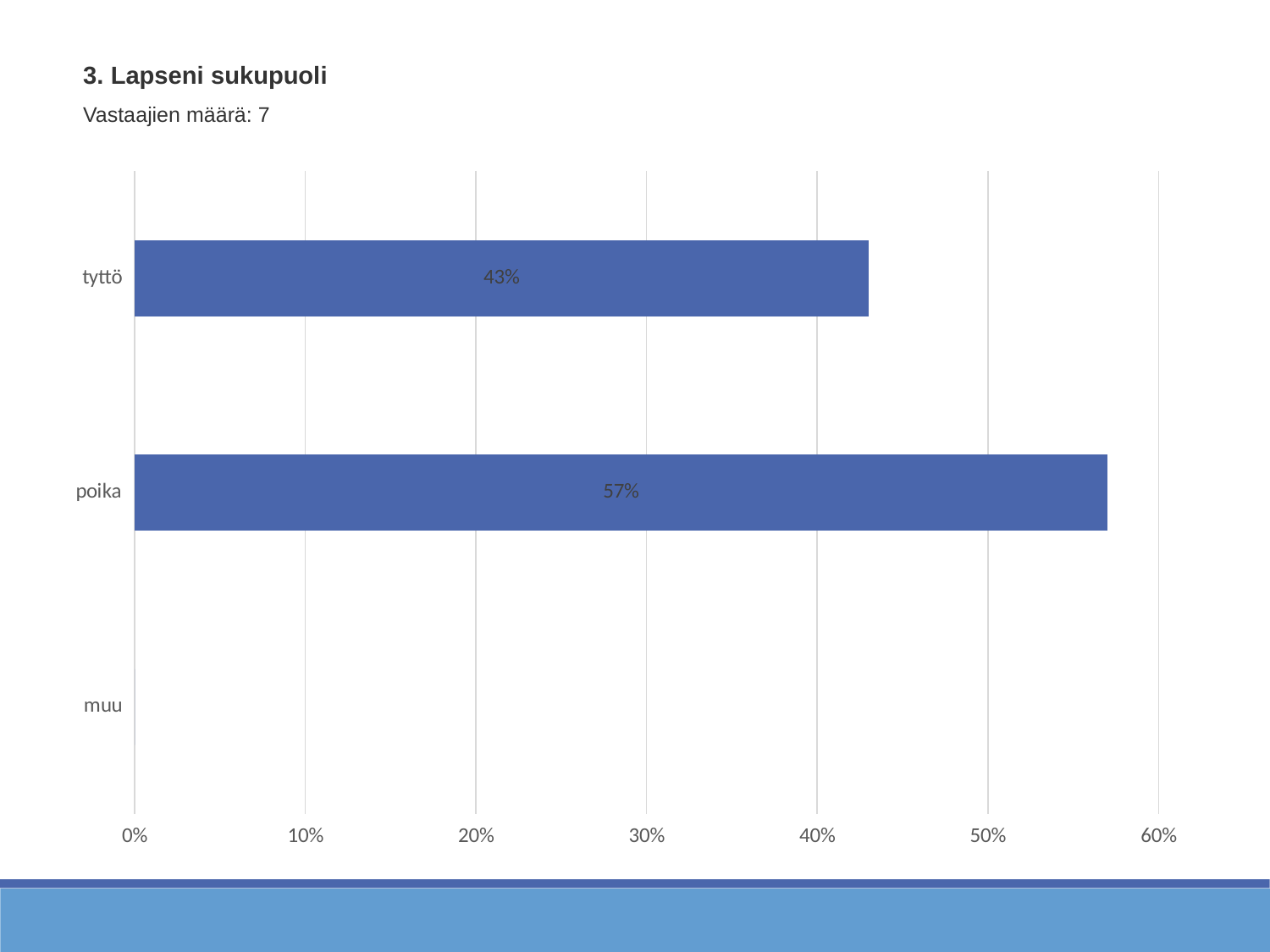
Is the value for poika greater or less than 50%? greater What is the value for poika? 57% Which category has the lowest value? muu What kind of chart is shown on the slide? bar chart Which is larger, the value for tyttö or the value for poika? poika How many categories are shown on the chart? 3 Is the value for tyttö greater or less than 40%? greater How many respondents (Vastaajien määrä) does the slide report? 7 Which category has the highest value? poika What is the difference between the values for poika and tyttö? 14% What is the title of the chart? 3. Lapseni sukupuoli What is the value for tyttö? 43%